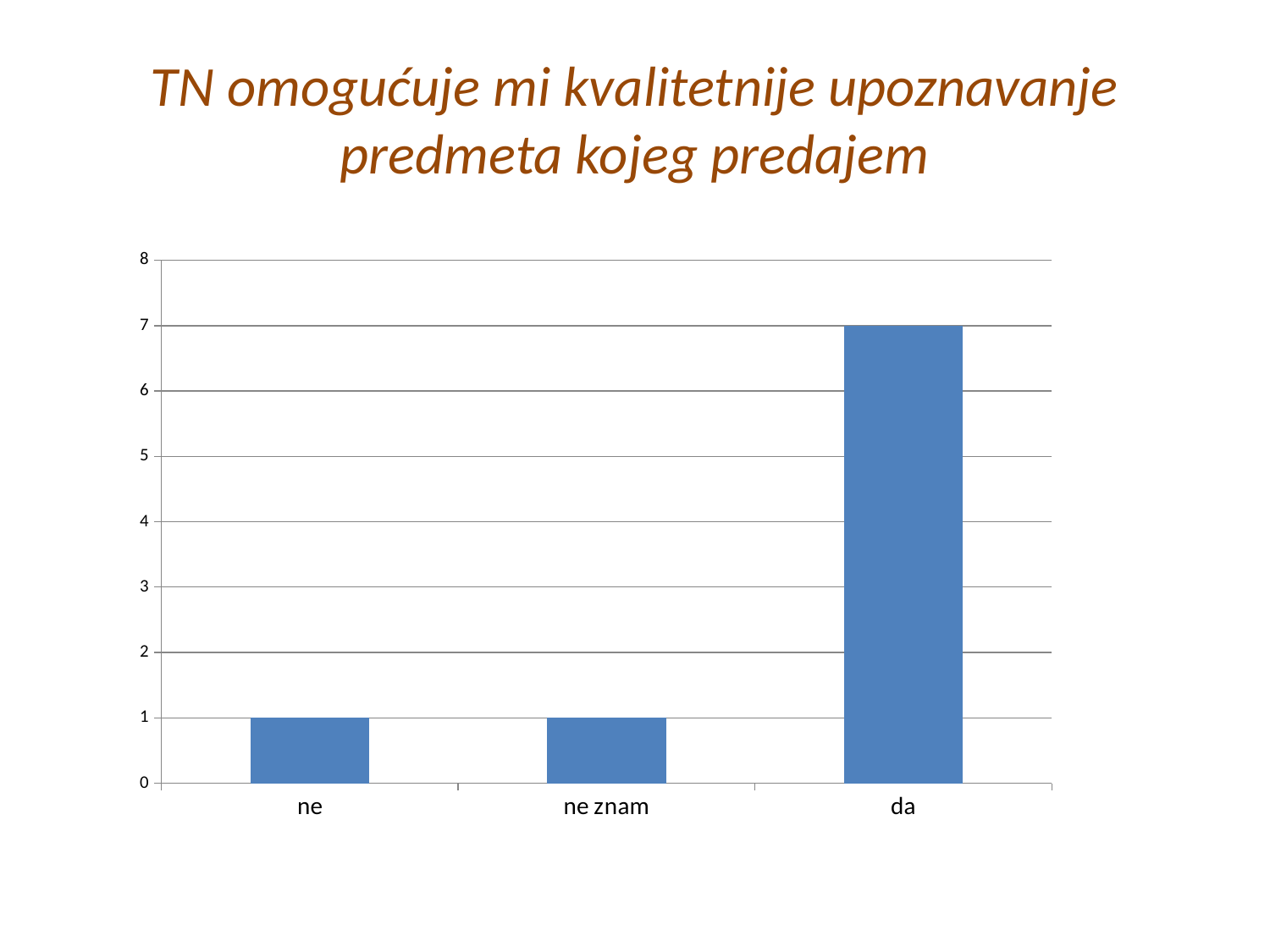
What is the maximum value shown on the vertical axis? 8 Is the value for "ne" greater or less than 2? less Which category has the highest value? da Which is larger, the value for "da" or the value for "ne znam"? da What kind of chart is shown on the slide? bar chart Is the value for "da" greater or less than 5? greater What is the value for "ne"? 1 How many categories are shown on the x axis? 3 What is the value for "ne znam"? 1 What is the title of the slide? TN omogućuje mi kvalitetnije upoznavanje predmeta kojeg predajem What is the value for "da"? 7 What is the difference between the values for "da" and "ne"? 6